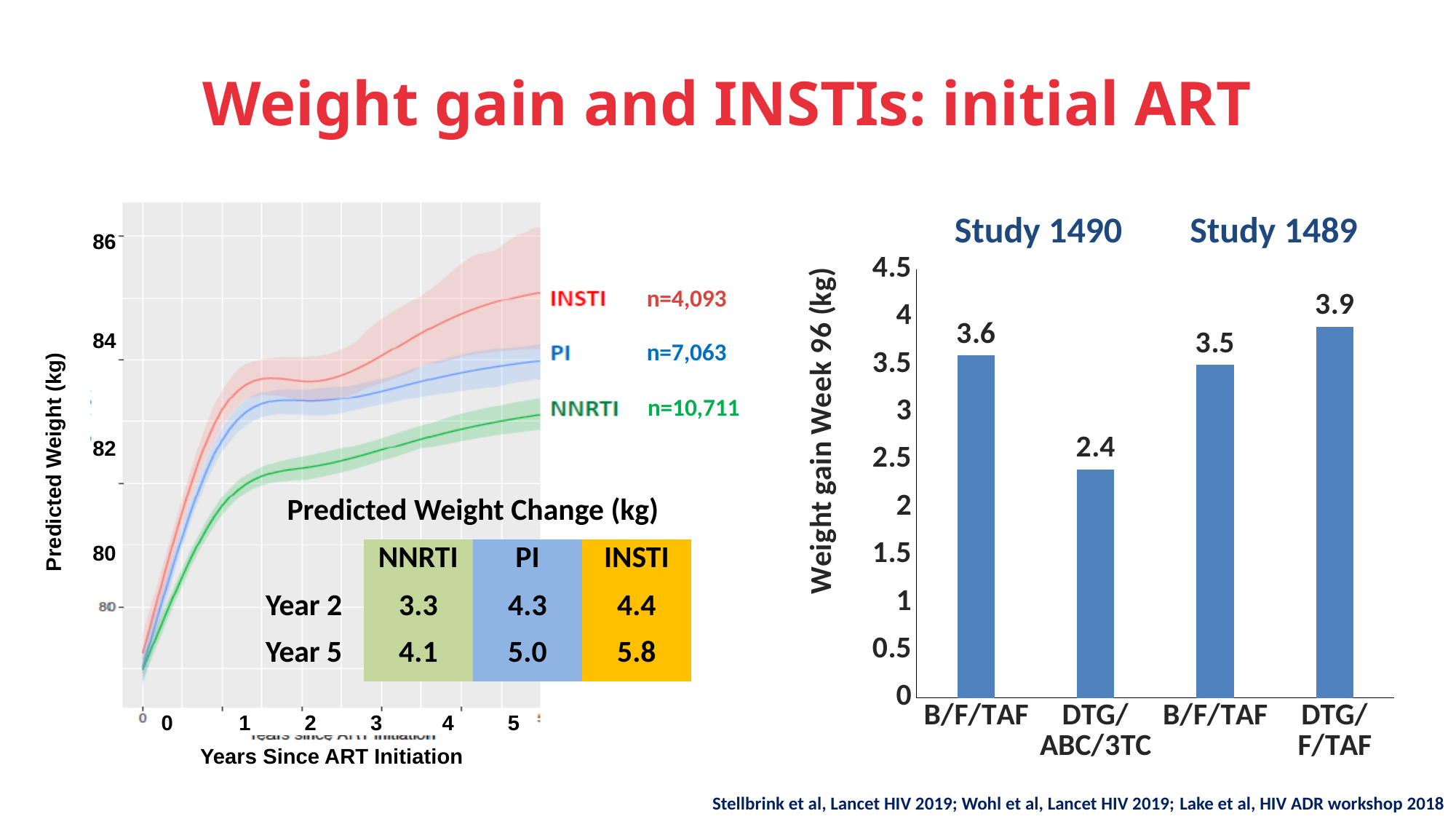
What kind of chart is the chart on the left showing Predicted Weight (kg)? Line chart On the line chart on the left, does the INSTI line rise or fall as years since ART initiation increase? Rise On the bar chart on the right, what is the weight gain at Week 96 for DTG/ABC/3TC in Study 1490? 2.4 How many bars are shown on the bar chart on the right? 4 On the bar chart on the right, what is the weight gain at Week 96 for DTG/F/TAF in Study 1489? 3.9 On the bar chart on the right, what is the difference between the B/F/TAF and DTG/ABC/3TC values in Study 1490? 1.2 On the bar chart on the right, in Study 1489, which is larger: B/F/TAF or DTG/F/TAF? DTG/F/TAF On the bar chart on the right, what is the weight gain at Week 96 for B/F/TAF in Study 1490? 3.6 On the bar chart on the right, which bar has the lowest value? DTG/ABC/3TC What kind of chart is the chart on the right? Bar chart On the bar chart on the right, which bar has the highest value? DTG/F/TAF On the line chart on the left, how many series are plotted? 3